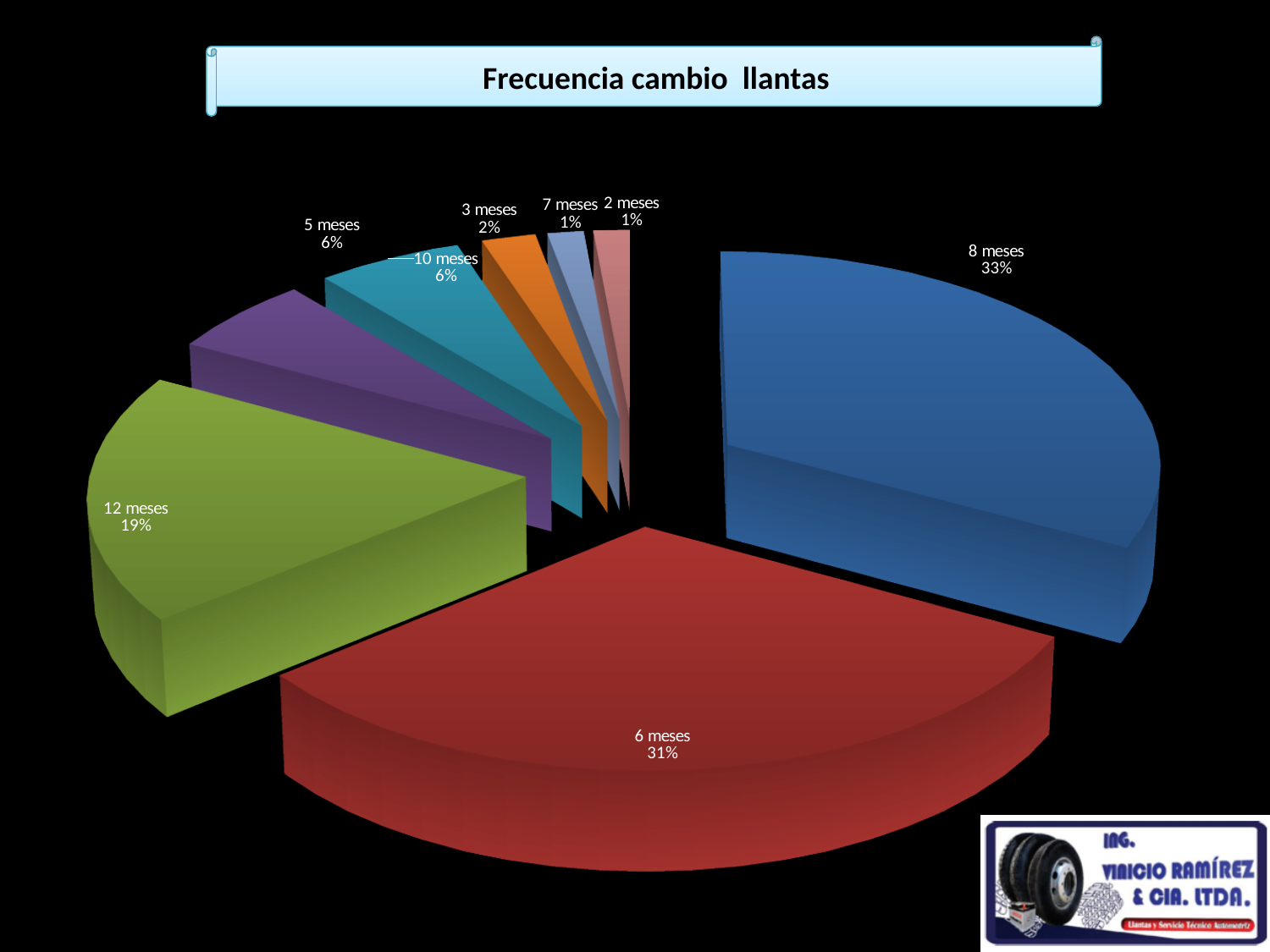
Which slice is larger, 10 meses or 3 meses? 10 meses What percentage is shown for 3 meses? 2% What kind of chart is shown on the slide? Pie chart What is the title of the chart? Frecuencia cambio llantas Which slice is larger, 12 meses or 5 meses? 12 meses How many slices does the pie chart have? 8 What is the value labelled for the 12 meses slice? 19% What is the difference in percentage points between the 6 meses and 12 meses slices? 12 Which category has the largest slice of the pie? 8 meses What share of the pie does the 8 meses slice represent? 33% What percentage is shown for 6 meses? 31% What is the difference in percentage points between the 8 meses and 6 meses slices? 2